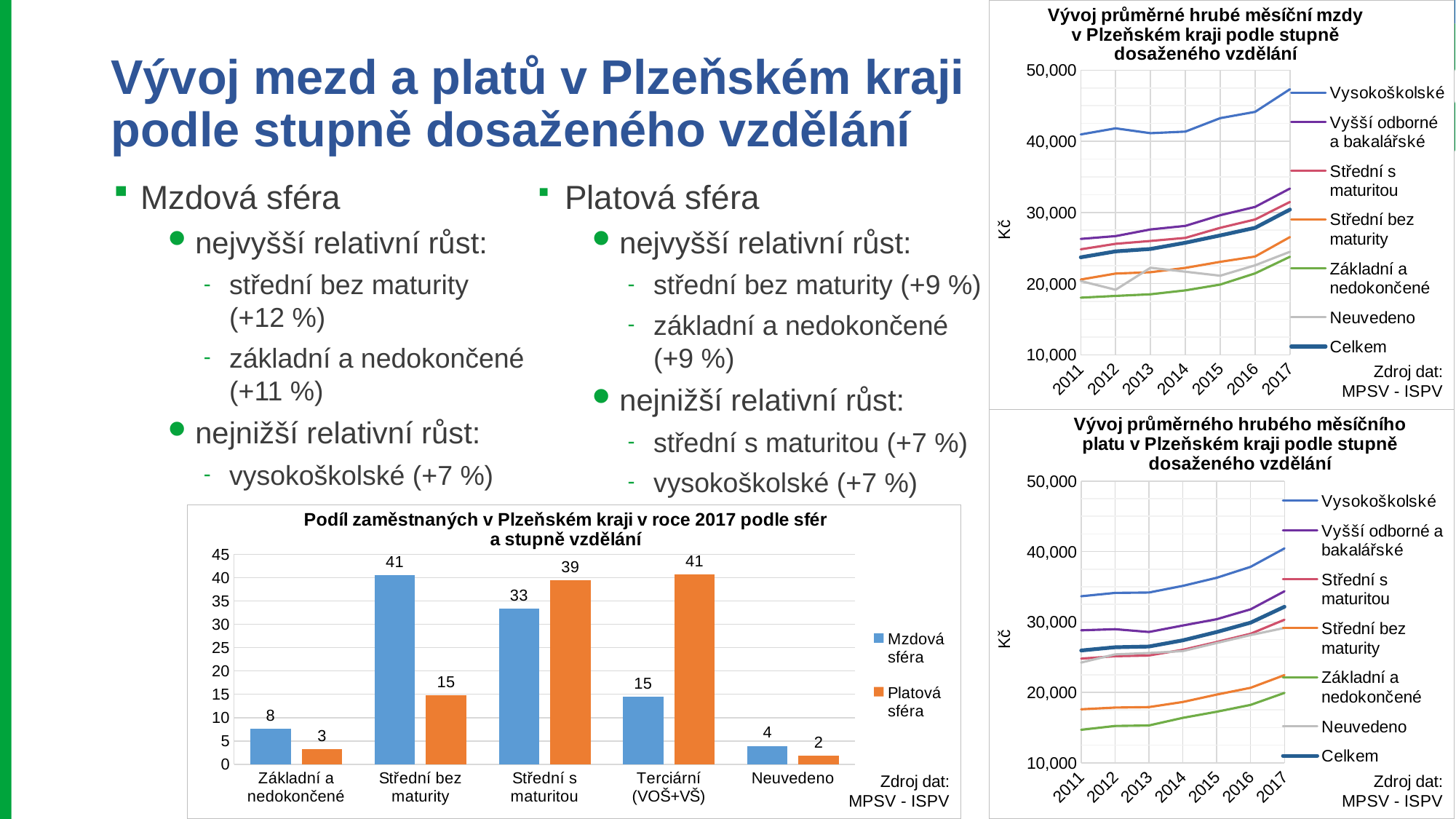
In the bottom-right chart 'Vývoj průměrného hrubého měsíčního platu v Plzeňském kraji podle stupně dosaženého vzdělání', does the Vysokoškolské series rise or fall from 2011 to 2017? rise In the chart 'Podíl zaměstnaných v Plzeňském kraji v roce 2017 podle sfér a stupně vzdělání', which is larger for Základní a nedokončené: Mzdová sféra or Platová sféra? Mzdová sféra In the chart 'Podíl zaměstnaných v Plzeňském kraji v roce 2017 podle sfér a stupně vzdělání', what is the value for Platová sféra in the category Terciární (VOŠ+VŠ)? 41 In the top-right chart 'Vývoj průměrné hrubé měsíční mzdy v Plzeňském kraji podle stupně dosaženého vzdělání', is the value for Vysokoškolské in 2017 greater or less than 40,000? greater In the chart 'Podíl zaměstnaných v Plzeňském kraji v roce 2017 podle sfér a stupně vzdělání', what is the difference between the Platová sféra and Mzdová sféra values for Střední s maturitou? 6 How many categories are shown on the x axis of the chart 'Podíl zaměstnaných v Plzeňském kraji v roce 2017 podle sfér a stupně vzdělání'? 5 How many series does the legend of the top-right chart 'Vývoj průměrné hrubé měsíční mzdy v Plzeňském kraji podle stupně dosaženého vzdělání' list? 7 In the bottom-right chart 'Vývoj průměrného hrubého měsíčního platu v Plzeňském kraji podle stupně dosaženého vzdělání', is the value for Základní a nedokončené in 2011 greater or less than 20,000? less In the chart 'Podíl zaměstnaných v Plzeňském kraji v roce 2017 podle sfér a stupně vzdělání', which category has the lowest value for Platová sféra? Neuvedeno What kind of chart is 'Podíl zaměstnaných v Plzeňském kraji v roce 2017 podle sfér a stupně vzdělání'? bar chart In the top-right chart 'Vývoj průměrné hrubé měsíční mzdy v Plzeňském kraji podle stupně dosaženého vzdělání', is the value for Základní a nedokončené in 2011 greater or less than 20,000? less In the chart 'Podíl zaměstnaných v Plzeňském kraji v roce 2017 podle sfér a stupně vzdělání', what is the value for Mzdová sféra in the category Střední bez maturity? 41